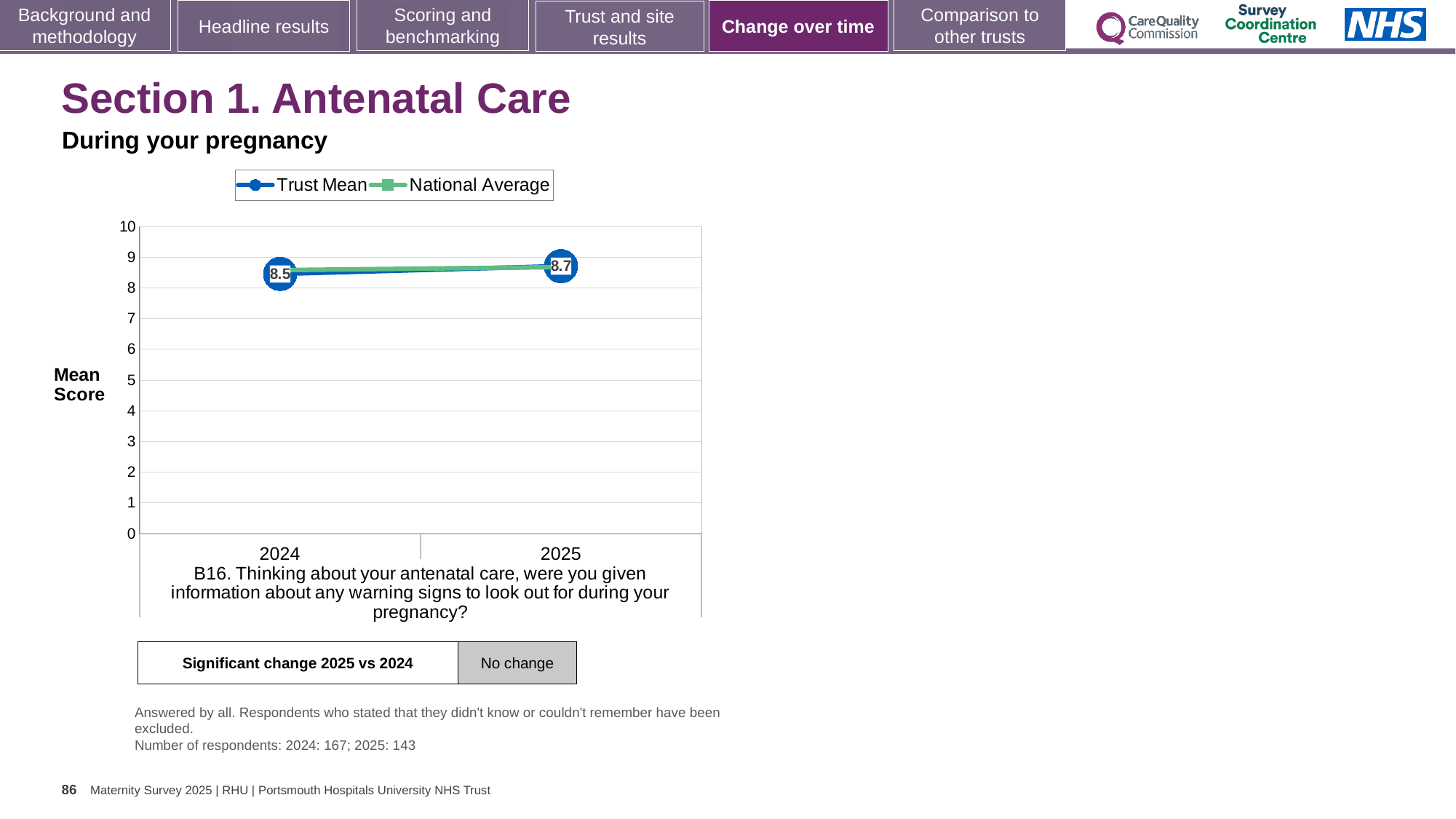
How many series does the legend list? 2 What is the difference between the Trust Mean in 2025 and in 2024? 0.2 Which is larger, the Trust Mean for 2024 or for 2025? 2025 How many years are shown on the x axis? 2 Does the Trust Mean rise or fall from 2024 to 2025? Rise In which year is the Trust Mean highest? 2025 In which year is the Trust Mean lowest? 2024 What is the Trust Mean value for 2025? 8.7 What is the label on the y axis of the chart? Mean Score Is the National Average value for 2024 greater or less than 8? greater What kind of chart is shown on the slide? Line chart What is the Trust Mean value for 2024? 8.5